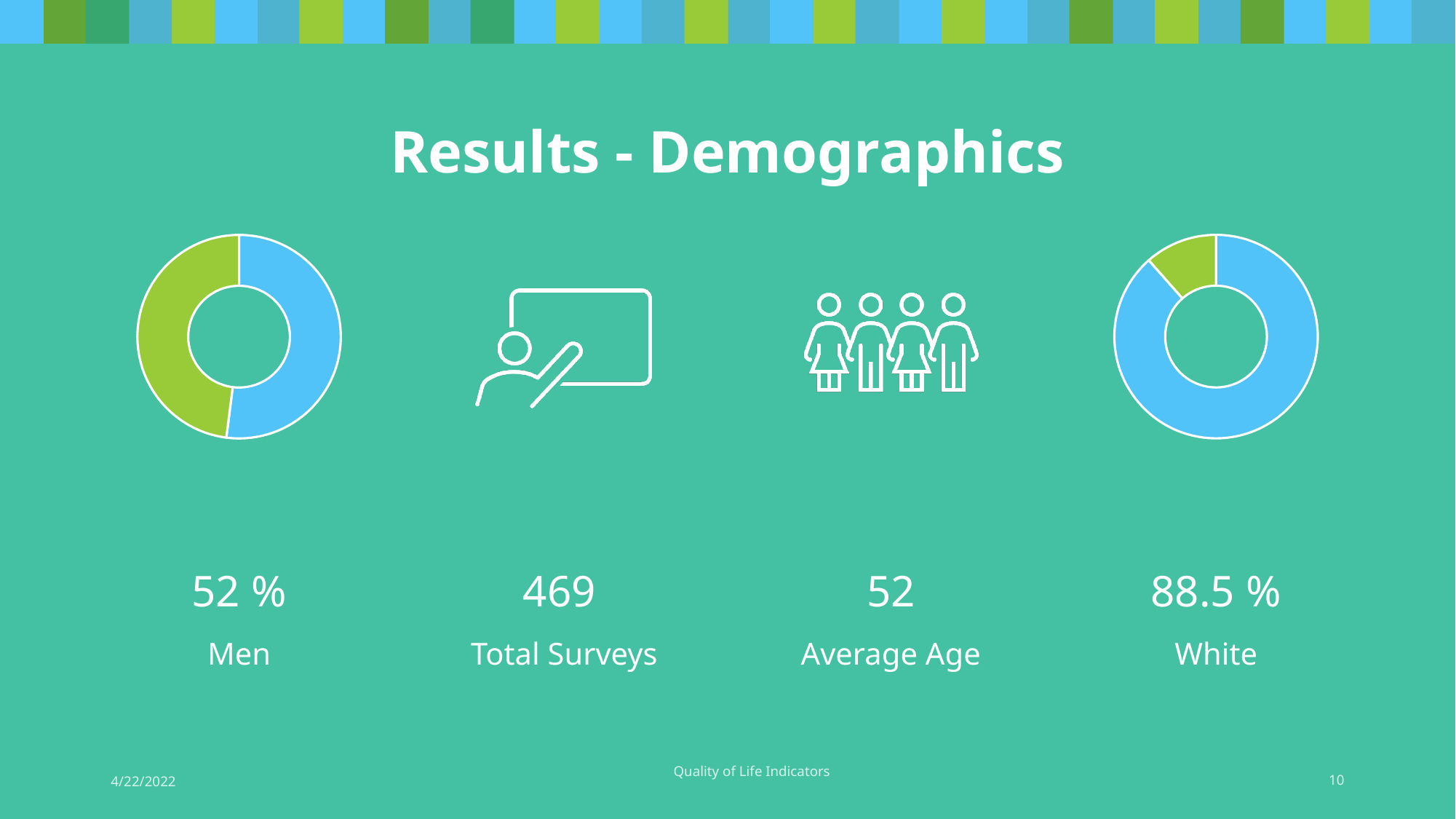
What is the difference in percentage points between the White share (right doughnut chart) and the Men share (left doughnut chart)? 36.5 How many slices does the right doughnut chart (White) have? 2 In the right doughnut chart (White), which slice is larger, the blue one or the green one? blue Which is larger: the share of Men in the left doughnut chart or the share of White respondents in the right doughnut chart? White What kind of chart is shown on the left of the slide, above the label "Men"? doughnut chart In the left doughnut chart, what percentage of respondents are Men? 52 % Is the Men share shown in the left doughnut chart greater or less than 50%? greater What colour is the slice representing White respondents in the right doughnut chart? blue What is the title of the slide containing the two doughnut charts? Results - Demographics How many slices does the left doughnut chart (Men) have? 2 In the left doughnut chart (Men), which slice is larger, the blue one or the green one? blue In the right doughnut chart, what percentage of respondents are White? 88.5 %